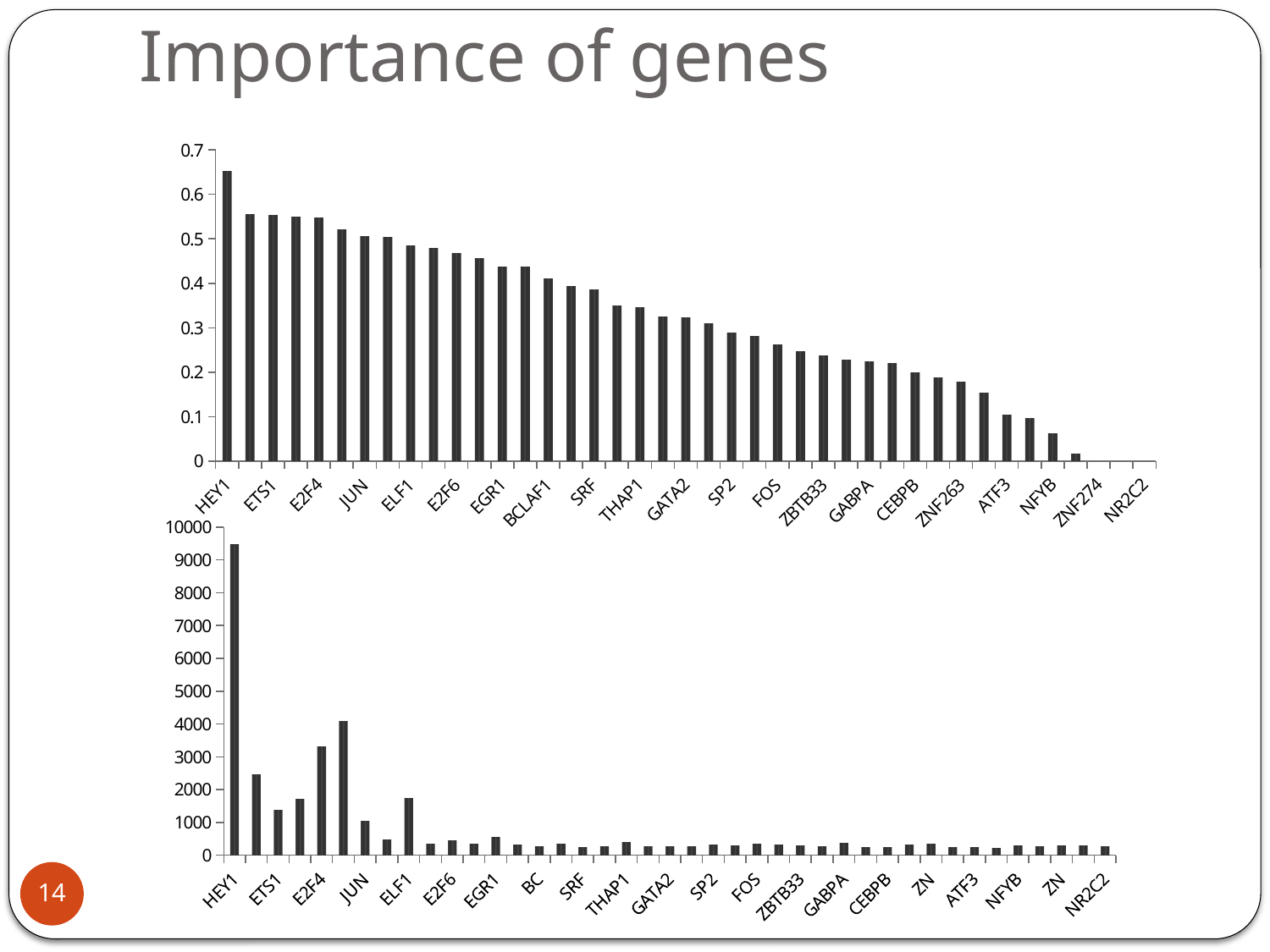
In the top chart, is the value for HEY1 greater or less than 0.6? greater In the top chart, is the value for NFYB greater or less than 0.1? less In the top chart, is the value for FOS greater or less than 0.3? less In the top chart, which gene has the highest value? HEY1 In the top chart, do the values rise or fall from left to right along the x axis? fall How many charts are shown on the slide? 2 In the top chart, which has the larger value, ETS1 or SP2? ETS1 What type of chart is the top chart on the slide? bar chart In the bottom chart, which has the larger value, JUN or ETS1? ETS1 In the bottom chart, which gene has the highest value? HEY1